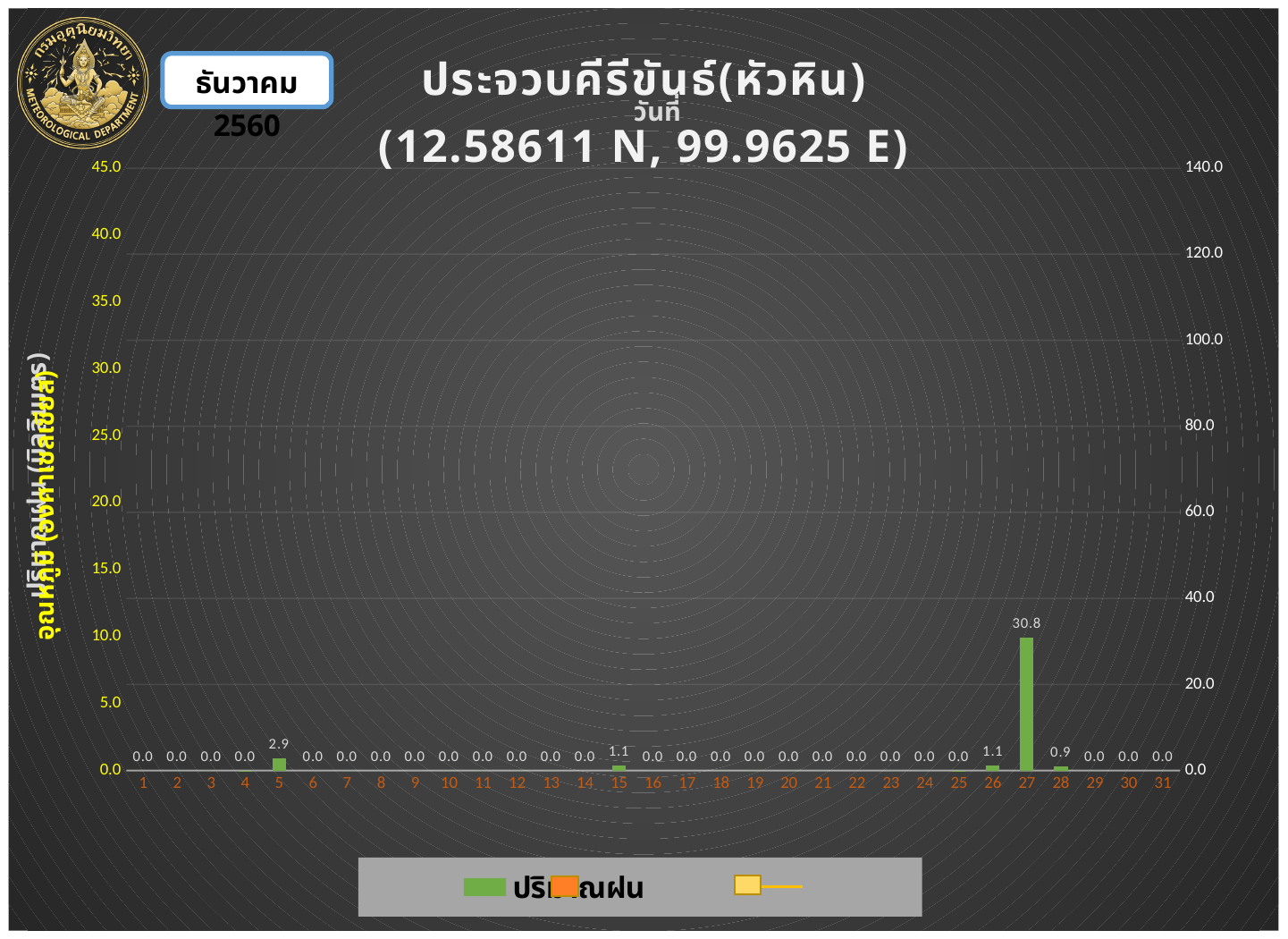
What is the difference between the rainfall values for day 27 and day 5? 27.9 How many days are shown on the x axis? 31 What is the rainfall value labelled for day 28? 0.9 Which day has the highest rainfall value? 27 What kind of chart is shown on the slide? Bar chart What is the rainfall value labelled for day 5? 2.9 Is the rainfall value for day 27 greater or less than 20.0 on the right axis? greater What month and year are shown in the box at the top left of the slide? ธันวาคม 2560 What is the highest value shown on the right-hand axis? 140.0 What is the rainfall value labelled for day 27? 30.8 What is the rainfall value labelled for day 15? 1.1 Which has a larger rainfall value, day 5 or day 26? Day 5